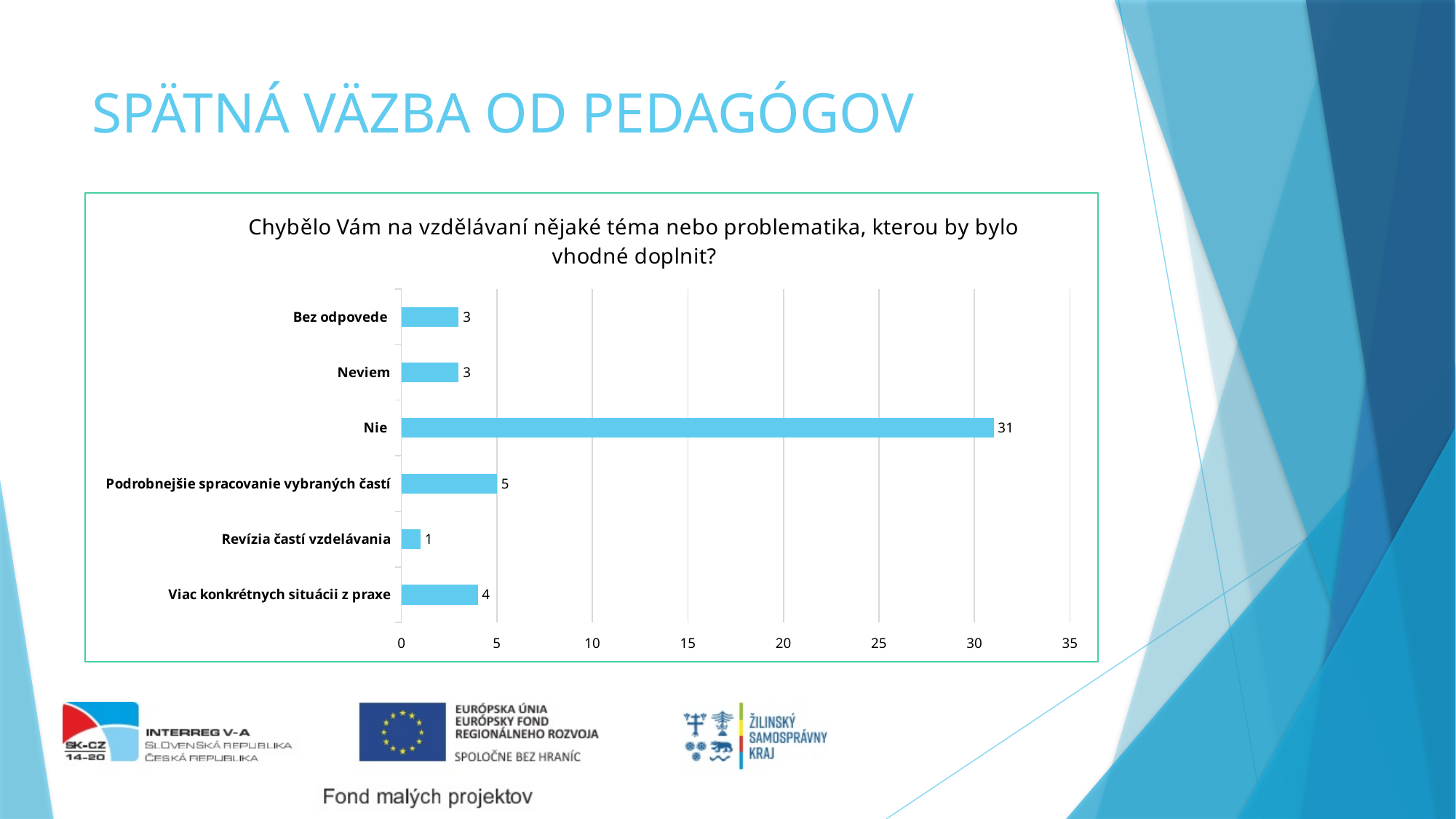
What kind of chart is shown on the slide? bar chart What is the difference between the values for "Nie" and "Podrobnejšie spracovanie vybraných častí"? 26 Is the value for "Nie" greater or less than 30? greater What is the value for "Revízia častí vzdelávania"? 1 What is the value for "Nie"? 31 What is the title of the chart? Chybělo Vám na vzdělávaní nějaké téma nebo problematika, kterou by bylo vhodné doplnit? Which is larger, the value for "Viac konkrétnych situácii z praxe" or the value for "Neviem"? Viac konkrétnych situácii z praxe What is the value for "Podrobnejšie spracovanie vybraných častí"? 5 Which category has the lowest value? Revízia častí vzdelávania Which category has the highest value? Nie How many categories are shown in the chart? 6 What is the value for "Viac konkrétnych situácii z praxe"? 4